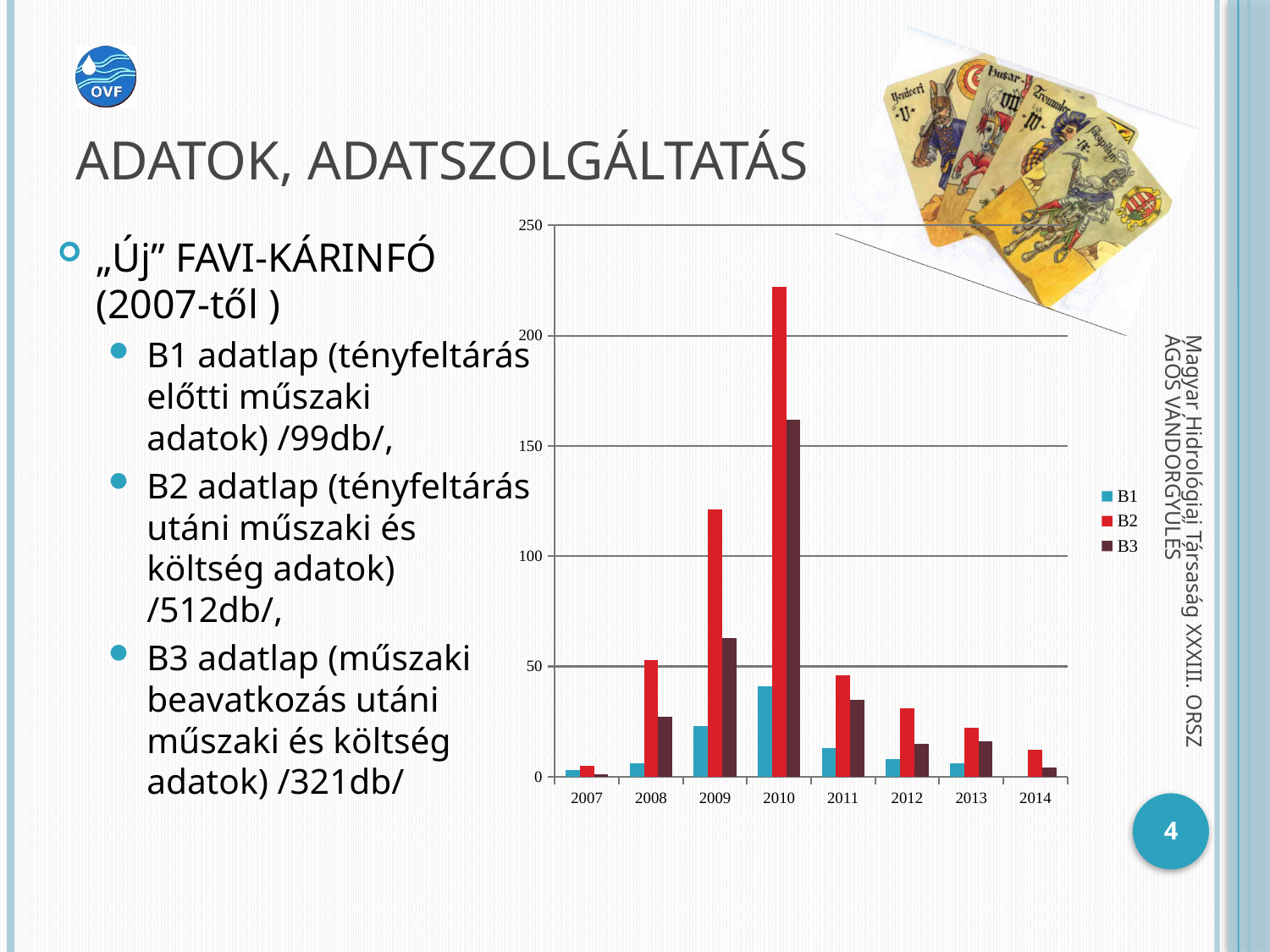
In 2010, which series has the larger value, B2 or B3? B2 In which year is the B2 series highest? 2010 What kind of chart is shown on the slide? bar chart How many series does the chart's legend list? 3 In which year is the B2 series lowest? 2007 Is the value for B2 in 2009 greater or less than 100? greater Do the B2 values rise or fall from 2010 to 2014? fall Is the value for B2 in 2010 greater or less than 200? greater Which is larger, the B2 value in 2008 or the B2 value in 2009? 2009 Is the value for B3 in 2010 greater or less than 150? greater How many years are shown on the x axis of the chart? 8